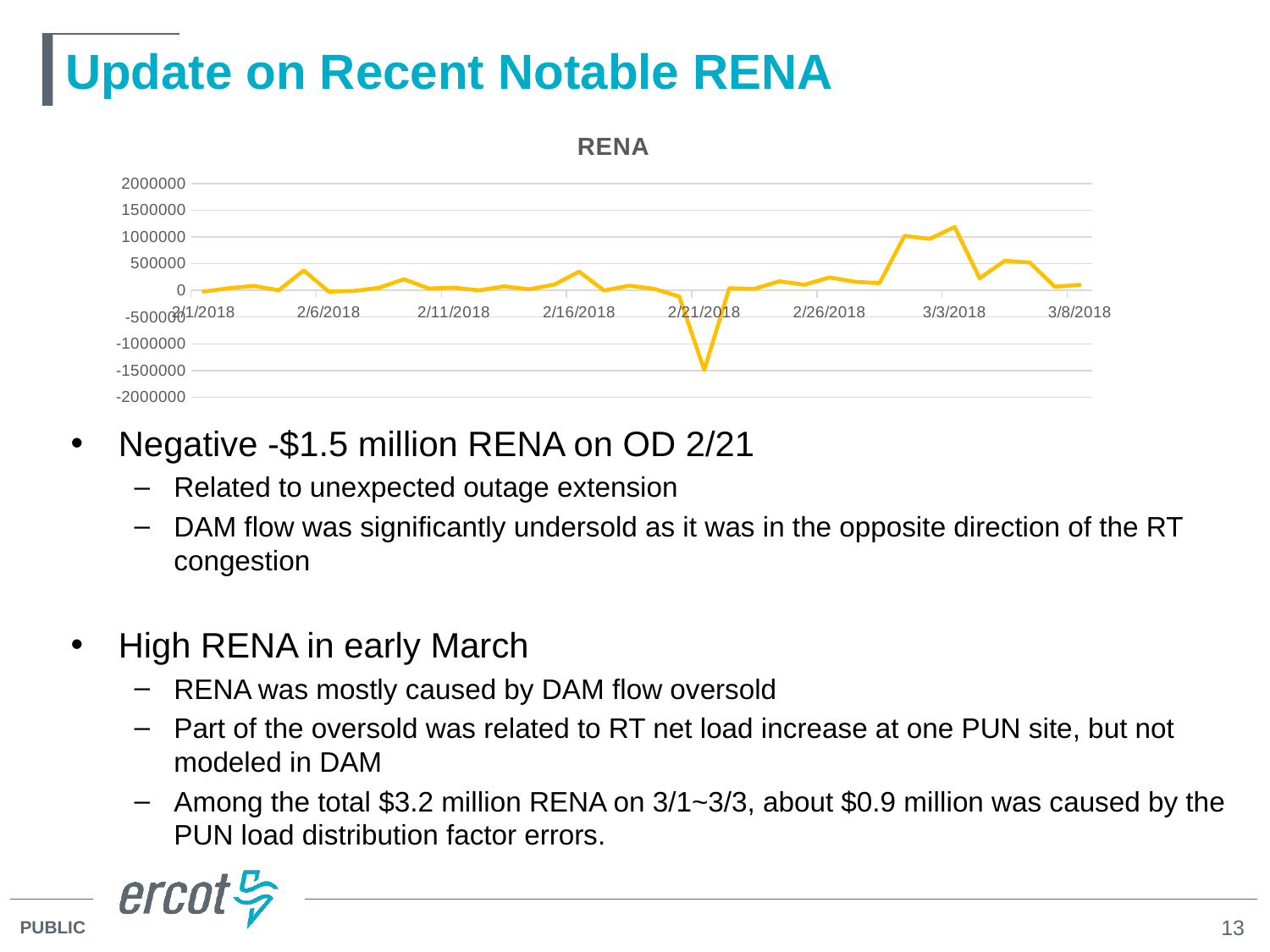
On which labeled date does the RENA line reach its highest value? 3/3/2018 Which date has the larger RENA value, 2/21/2018 or 3/3/2018? 3/3/2018 Is the RENA value on 2/26/2018 greater or less than 500000? less Is the RENA value on 3/3/2018 greater or less than 1000000? greater On which date does the RENA line reach its lowest value? 2/21/2018 How many date labels are shown on the x axis of the chart? 8 What kind of chart is shown on the slide? line chart What is the title of the chart? RENA Which date has the larger RENA value, 2/1/2018 or 2/21/2018? 2/1/2018 Is the RENA value on 2/1/2018 greater or less than 500000? less What is the highest value labeled on the y axis of the chart? 2000000